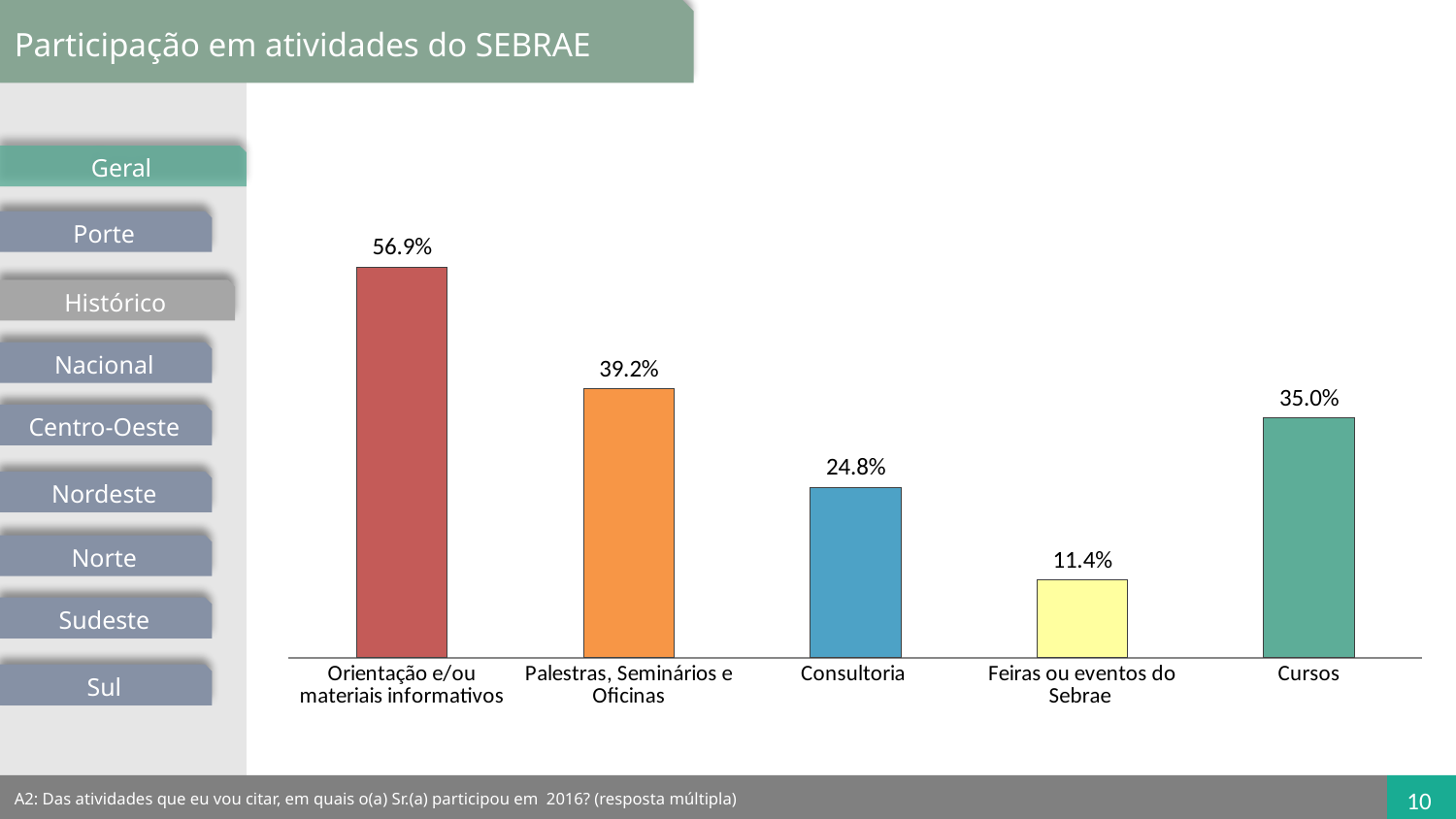
Which category has the highest value? Orientação e/ou materiais informativos What is the value for Feiras ou eventos do Sebrae? 11.4% What colour is the bar for Feiras ou eventos do Sebrae? Yellow How many categories are shown in the chart? 5 Which is larger, the value for Palestras, Seminários e Oficinas or the value for Cursos? Palestras, Seminários e Oficinas What is the title of the slide? Participação em atividades do SEBRAE What is the difference between the values for Cursos and Consultoria? 10.2% What kind of chart is shown on the slide? Bar chart Which category has the lowest value? Feiras ou eventos do Sebrae What is the value for Cursos? 35.0% What is the value for Consultoria? 24.8% What is the difference between the values for Orientação e/ou materiais informativos and Palestras, Seminários e Oficinas? 17.7%